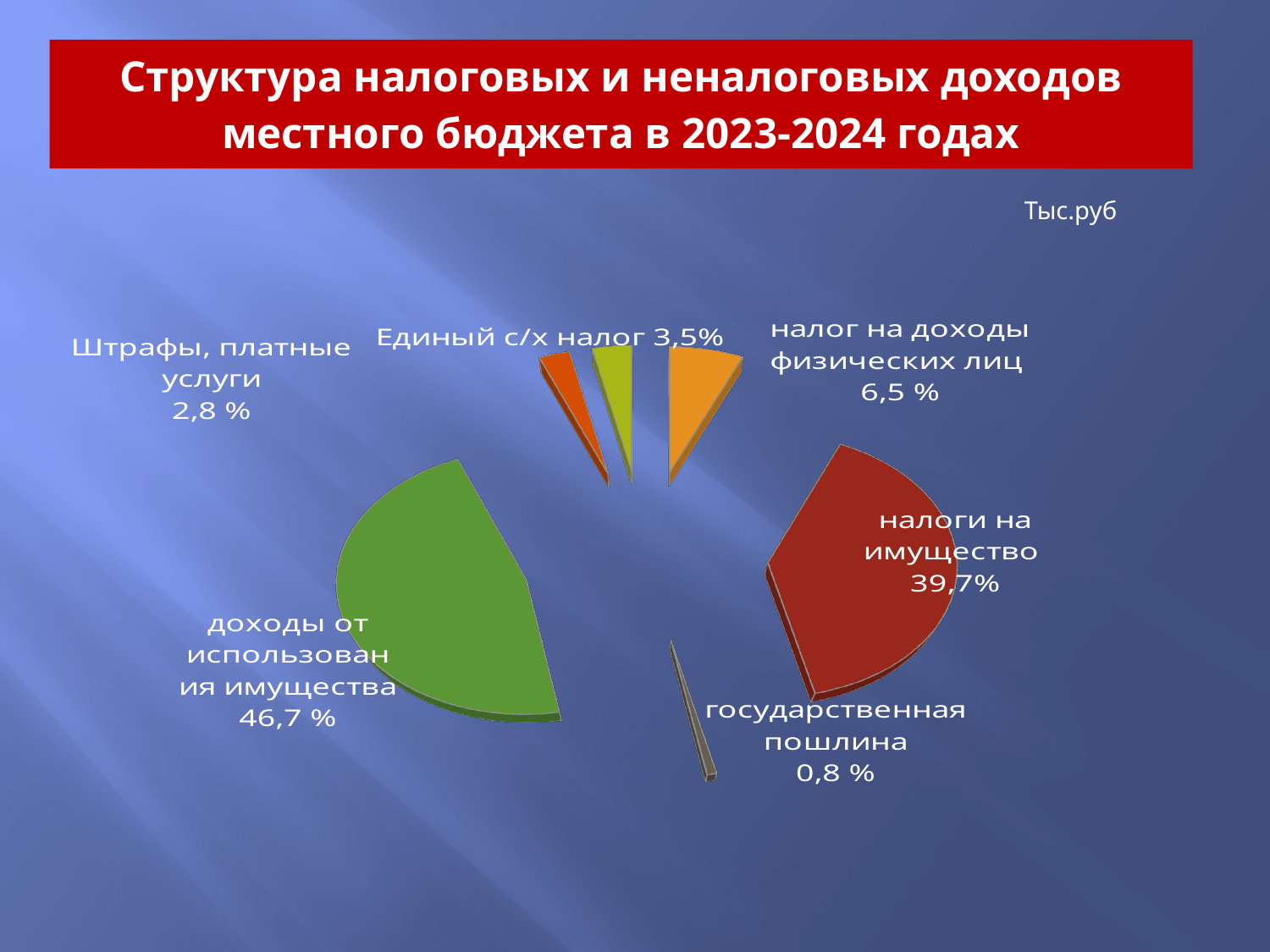
What percentage is shown for "налог на доходы физических лиц"? 6,5 % Which category has the smallest share of the pie? государственная пошлина What is the difference in percentage points between "доходы от использования имущества" and "налоги на имущество"? 7 % What percentage is shown for "государственная пошлина"? 0,8 % How many slices does the pie chart have? 6 What percentage is shown for "налоги на имущество"? 39,7% What percentage is shown for "Единый с/х налог"? 3,5% Which is larger: the share for "Штрафы, платные услуги" or for "Единый с/х налог"? Единый с/х налог Which category has the largest share of the pie? доходы от использования имущества What share of the pie is labelled "доходы от использования имущества"? 46,7 % What unit is indicated in the top right corner of the slide? Тыс.руб What kind of chart is shown on the slide? pie chart